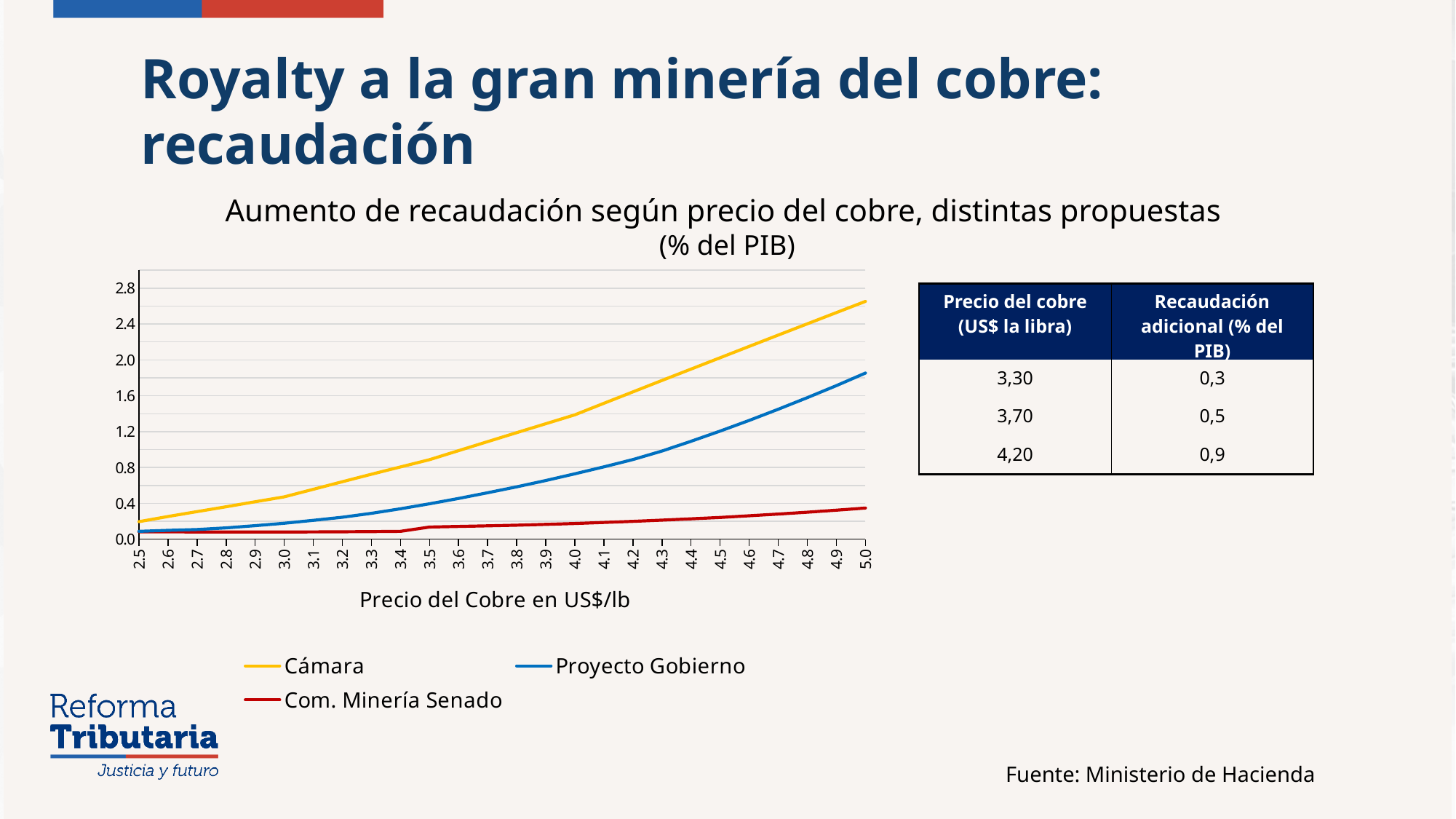
Which series are listed in the chart legend? Cámara, Proyecto Gobierno, Com. Minería Senado Do the values of the Cámara series rise or fall as the copper price increases along the x axis? rise How many series does the chart legend list? 3 Is the value for Com. Minería Senado at a copper price of 5.0 greater or less than 0.4? less Is the value for Proyecto Gobierno at a copper price of 5.0 greater or less than 1.6? greater Which series has the highest value at a copper price of 5.0? Cámara How many copper price points are shown along the x axis of the chart? 26 Which series has the lowest value at a copper price of 5.0? Com. Minería Senado At a copper price of 4.5, which is larger: the value for Cámara or the value for Proyecto Gobierno? Cámara Is the value for Cámara at a copper price of 5.0 greater or less than 2.4? greater What is the label of the x axis of the chart? Precio del Cobre en US$/lb What kind of chart is shown on the slide? line chart